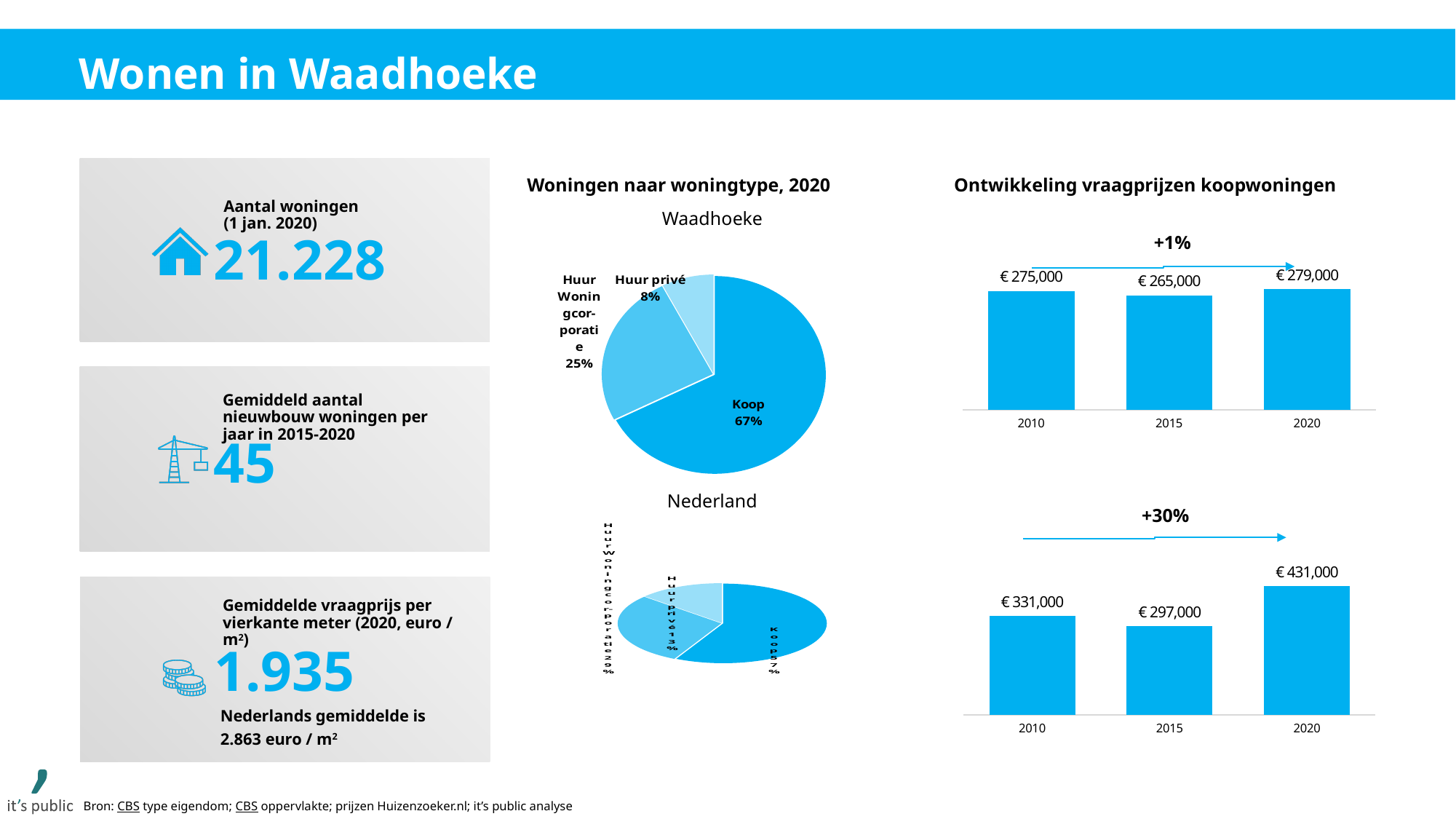
In the Waadhoeke pie chart, which category has the largest slice? Koop In the upper bar chart under 'Ontwikkeling vraagprijzen koopwoningen', what is the value for 2015? € 265,000 What percentage change is shown above the lower bar chart under 'Ontwikkeling vraagprijzen koopwoningen'? +30% How many slices does the Waadhoeke pie chart have? 3 In the upper bar chart under 'Ontwikkeling vraagprijzen koopwoningen', what is the difference between 2020 and 2010? € 4,000 In the Waadhoeke pie chart, what share is Koop? 67% In the upper bar chart under 'Ontwikkeling vraagprijzen koopwoningen', which year has the highest value? 2020 In the lower bar chart under 'Ontwikkeling vraagprijzen koopwoningen', what is the value for 2020? € 431,000 In the Waadhoeke pie chart, which category has the smallest slice? Huur privé In the lower bar chart under 'Ontwikkeling vraagprijzen koopwoningen', what is the difference between 2020 and 2015? € 134,000 In the lower bar chart under 'Ontwikkeling vraagprijzen koopwoningen', which year has the lowest value? 2015 In the Waadhoeke pie chart, what share is Huur privé? 8%